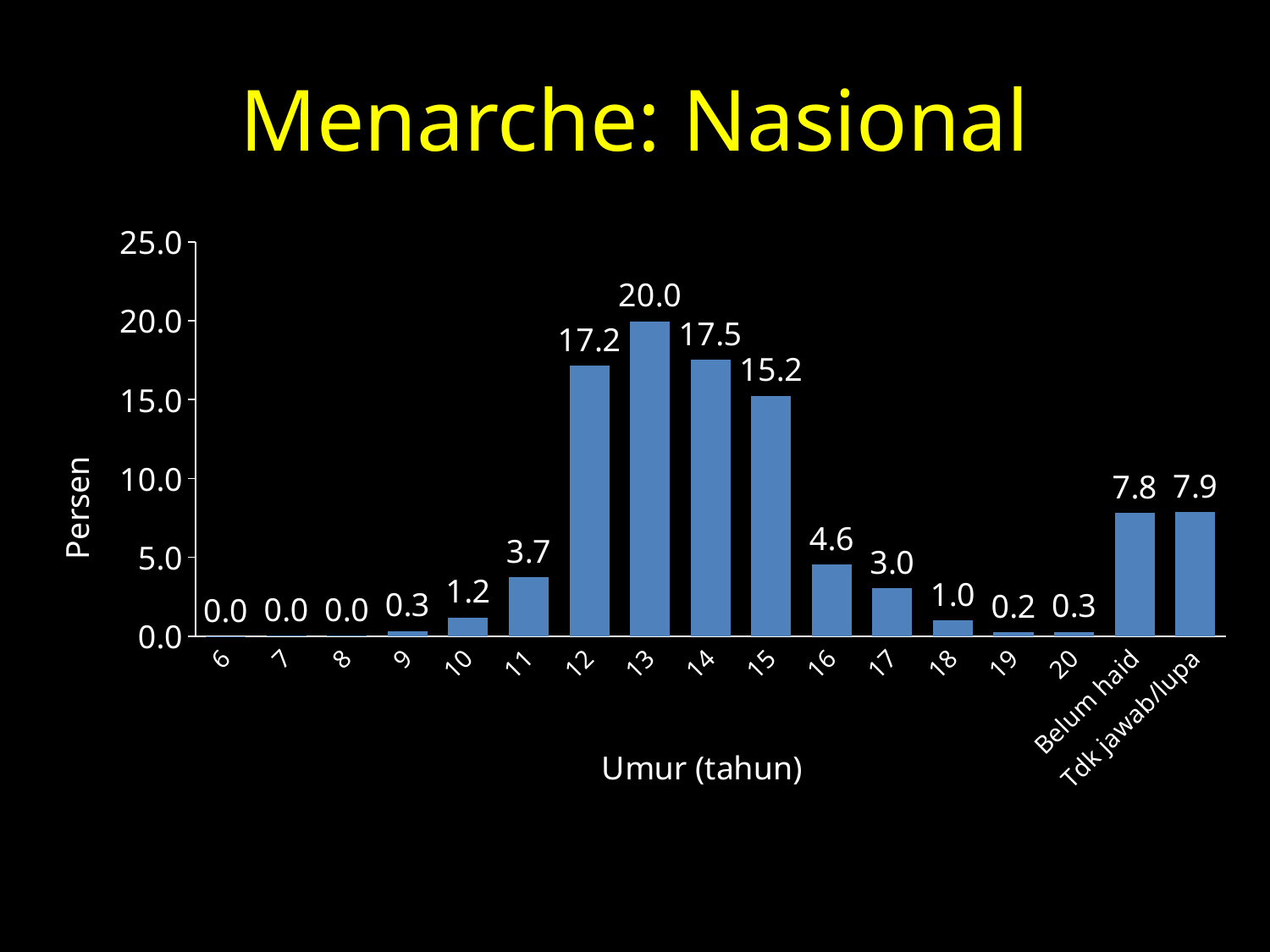
What is the value for age 13? 20.0 What is the value for 'Belum haid'? 7.8 What kind of chart is shown on the slide? bar chart How many categories are shown on the x axis? 17 What is the value for age 15? 15.2 What is the value for 'Tdk jawab/lupa'? 7.9 What is the difference between the values for age 12 and age 14? 0.3 Is the value for age 12 greater or less than 15.0? greater Which is larger, the value for age 16 or the value for age 17? 16 What is the difference between the values for age 13 and age 15? 4.8 What is the title of the slide? Menarche: Nasional Which age category has the highest value? 13